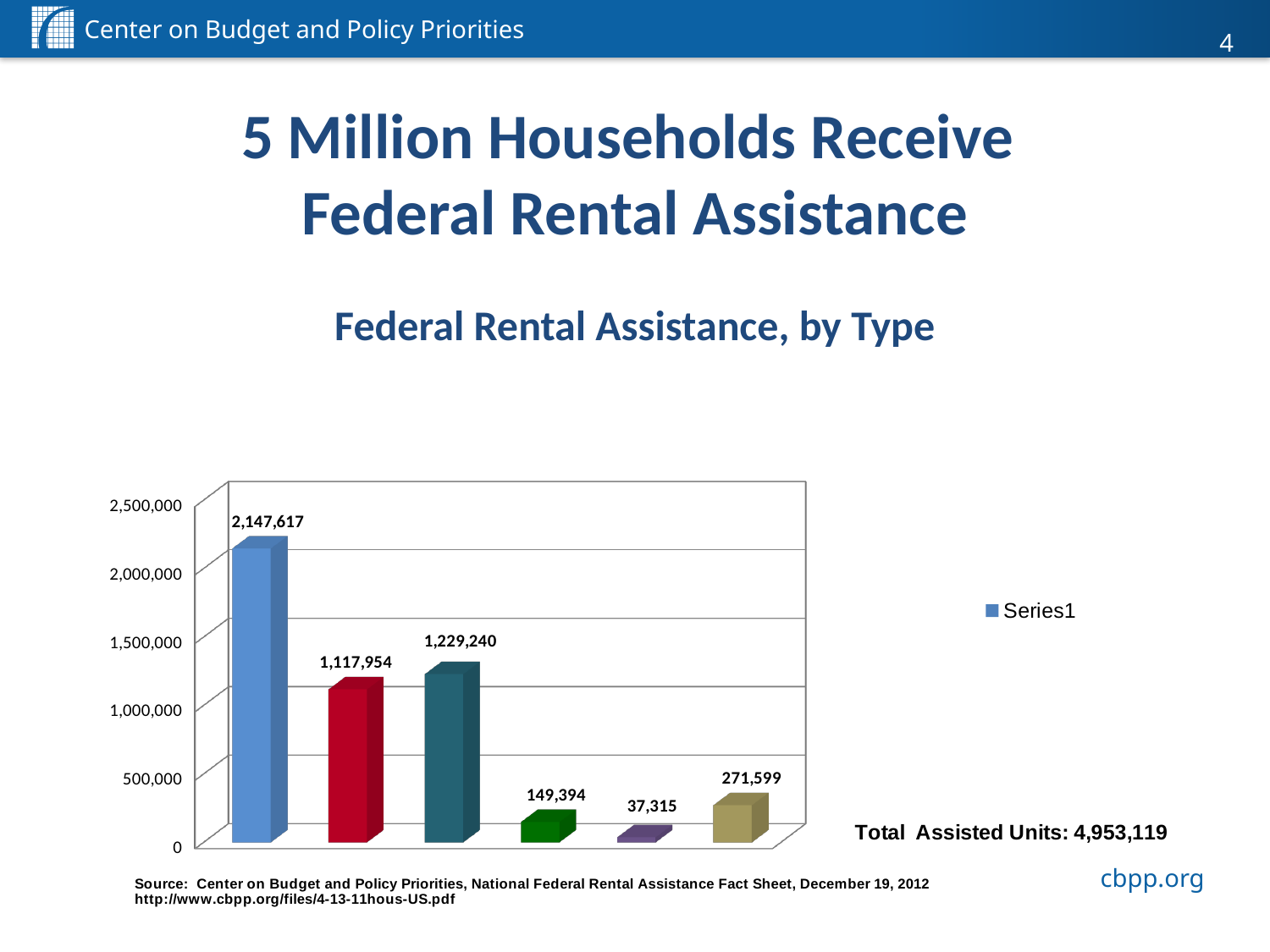
What is the value shown on the second (red) bar from the left? 1,117,954 What is the value shown on the purple bar? 37,315 What is the value shown on the third (teal) bar from the left? 1,229,240 Which is larger, the second bar or the third bar? the third bar (1,229,240) What is the value shown on the first (blue) bar from the left? 2,147,617 What is the value shown on the last (tan) bar on the right? 271,599 How many bars are plotted in the chart? 6 Which bar has the lowest value? the purple bar (37,315) What is the title of the chart? Federal Rental Assistance, by Type What type of chart is shown on the slide? bar chart What is the difference between the first bar (2,147,617) and the third bar (1,229,240)? 918,377 How many series does the legend list? 1